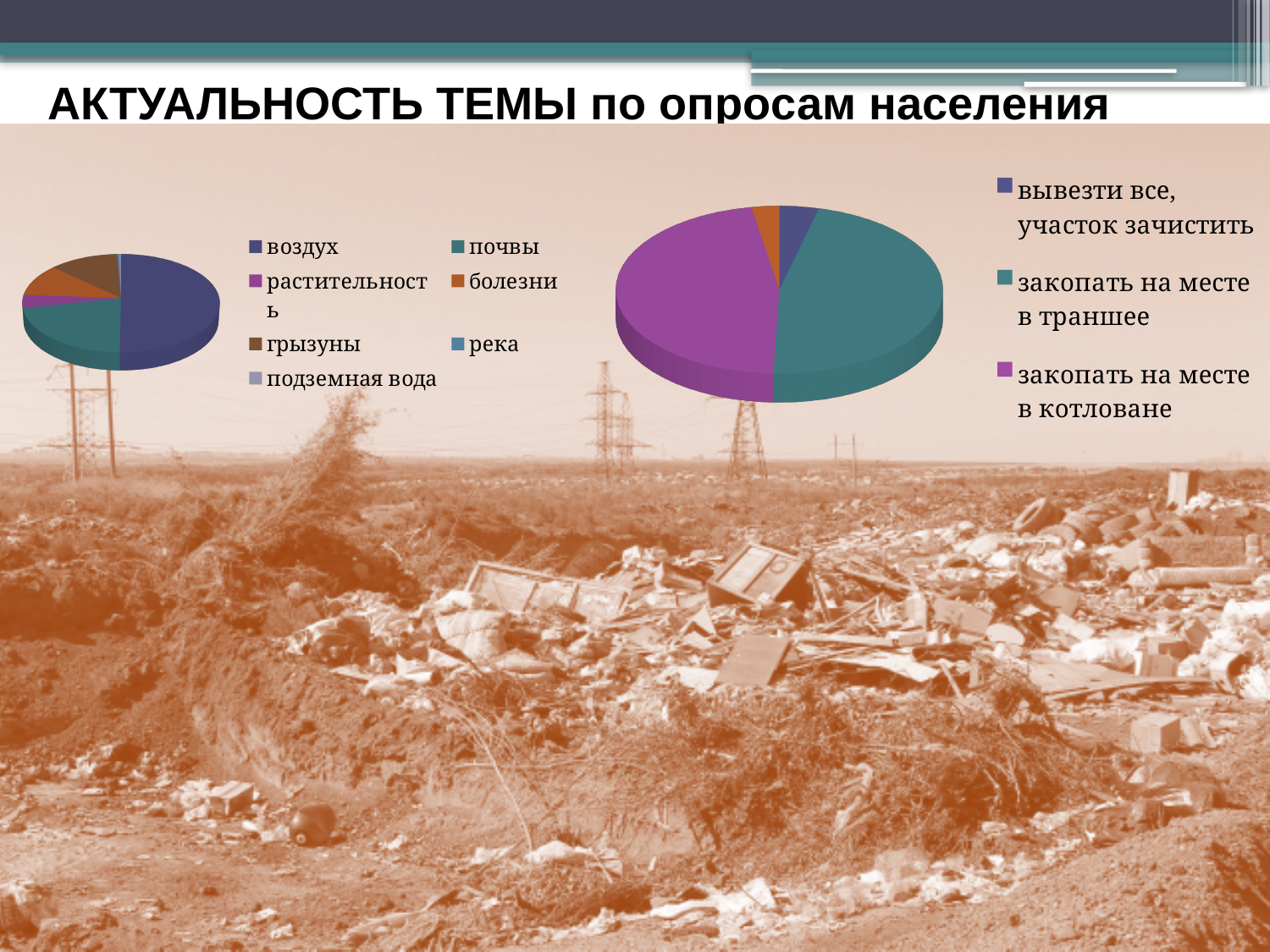
In the left pie chart, which slice is larger: 'почвы' or 'болезни'? почвы In the left pie chart, what colour is the 'воздух' slice? dark blue In the right pie chart, which of the legend entries has the smallest slice? вывезти все, участок зачистить In the left pie chart, how many entries does the legend list? 7 In the left pie chart, which category has the largest slice? воздух What is the title of the slide containing the two pie charts? АКТУАЛЬНОСТЬ ТЕМЫ по опросам населения In the left pie chart, which slice is larger: 'воздух' or 'грызуны'? воздух In the right pie chart, how many entries does the legend list? 3 In the right pie chart, which slice is larger: 'закопать на месте в траншее' or 'вывезти все, участок зачистить'? закопать на месте в траншее What kind of chart is the right chart on the slide? pie chart What kind of chart is the left chart on the slide? pie chart